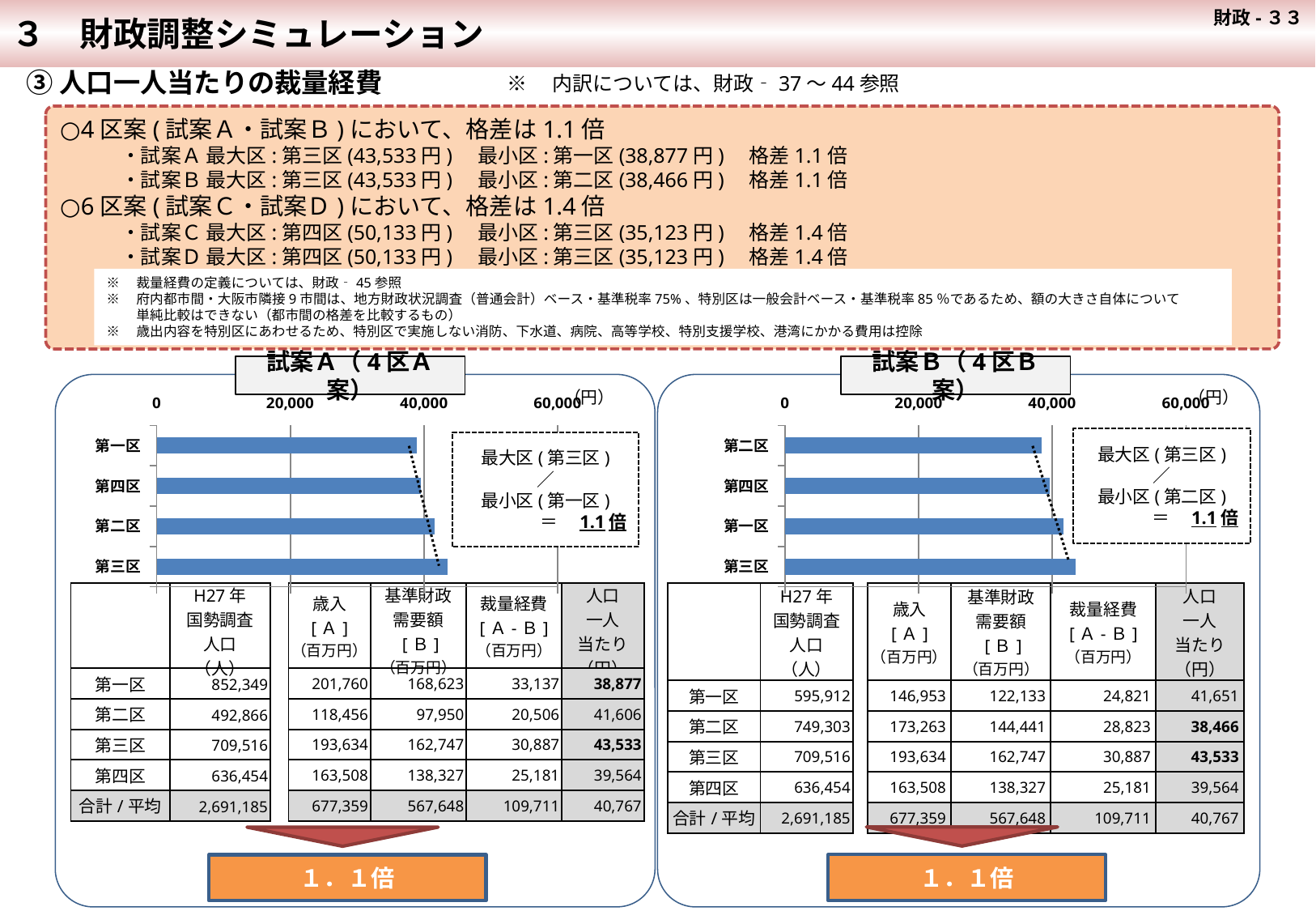
In the 試案B（4区B案） chart, is the value for 第一区 greater or less than 20,000? greater What ratio (格差) between the 最大区 and 最小区 is shown in the box on the 試案B（4区B案） chart? 1.1倍 In the 試案A（4区A案） chart, what is the difference between the 最大区 (第三区, 43,533円) and the 最小区 (第一区, 38,877円)? 4,656円 In the 試案B（4区B案） chart, which 区 has the lowest 人口一人当たり value? 第二区 What kind of chart is the 試案A（4区A案） chart? bar chart How many 区 categories are plotted in the 試案A（4区A案） chart? 4 In the 試案B（4区B案） chart, which 区 has the highest 人口一人当たり value? 第三区 In the 試案B（4区B案） chart, what is the 人口一人当たり value for 第二区 as shown in the table? 38,466 In the 試案A（4区A案） chart, is the value for 第三区 greater or less than 40,000? greater In the 試案A（4区A案） chart, what is the 人口一人当たり value for 第三区 as shown in the table? 43,533 In the 試案A（4区A案） chart, which 区 has the lowest 人口一人当たり value? 第一区 In the 試案A（4区A案） chart, which 区 has the highest 人口一人当たり value? 第三区